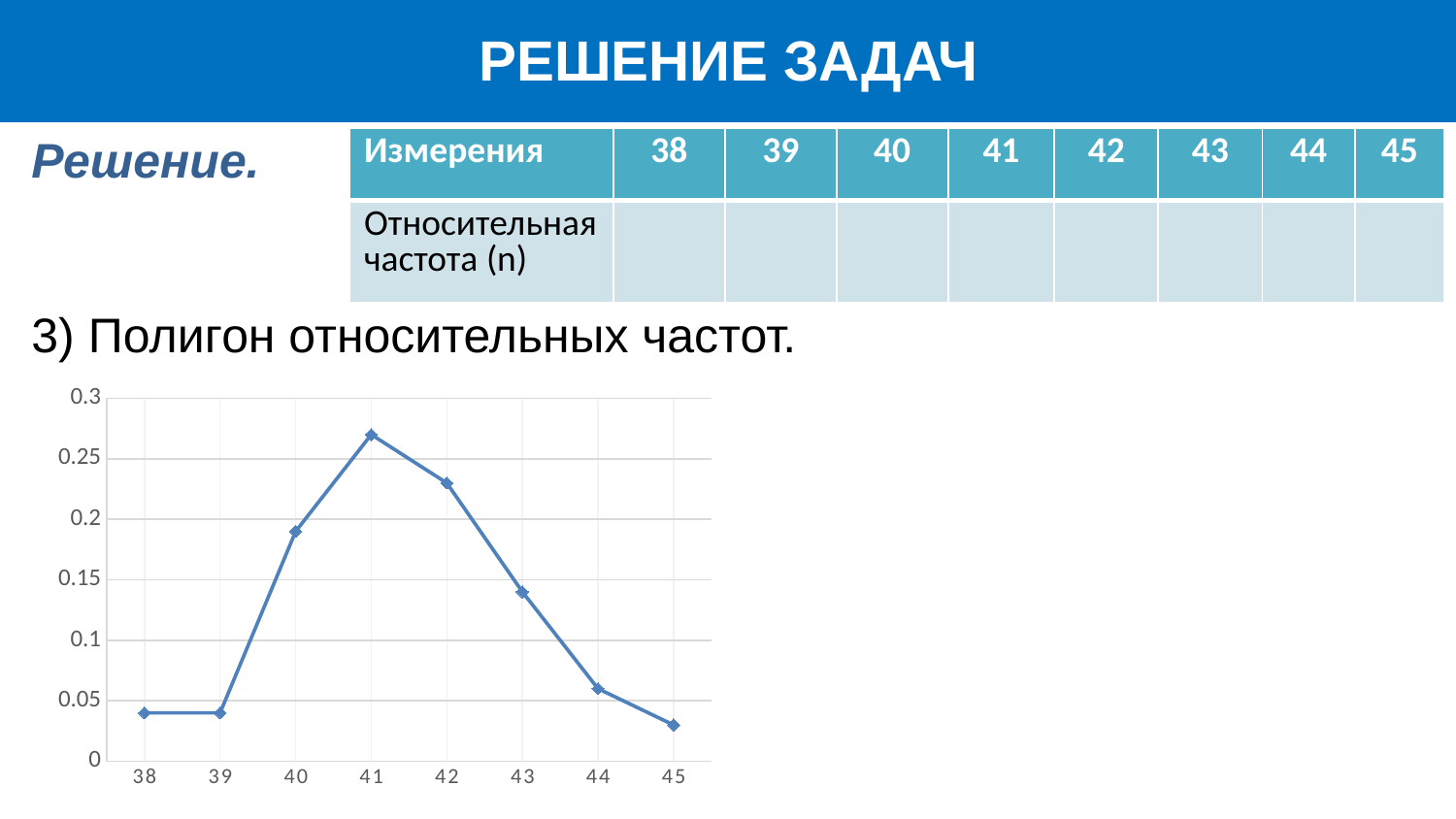
Do the values rise or fall along the x axis from 41 to 45? fall Is the value at 41 greater or less than 0.25? greater Which is larger, the value at 40 or the value at 42? 42 Do the values rise or fall along the x axis from 39 to 41? rise Is the value at 42 greater or less than 0.2? greater Is the value at 38 greater or less than 0.05? less How many data points are plotted on the line chart? 8 Which x-axis value has the highest relative frequency on the chart? 41 What kind of chart is shown on the slide? line chart Which is larger, the value at 43 or the value at 44? 43